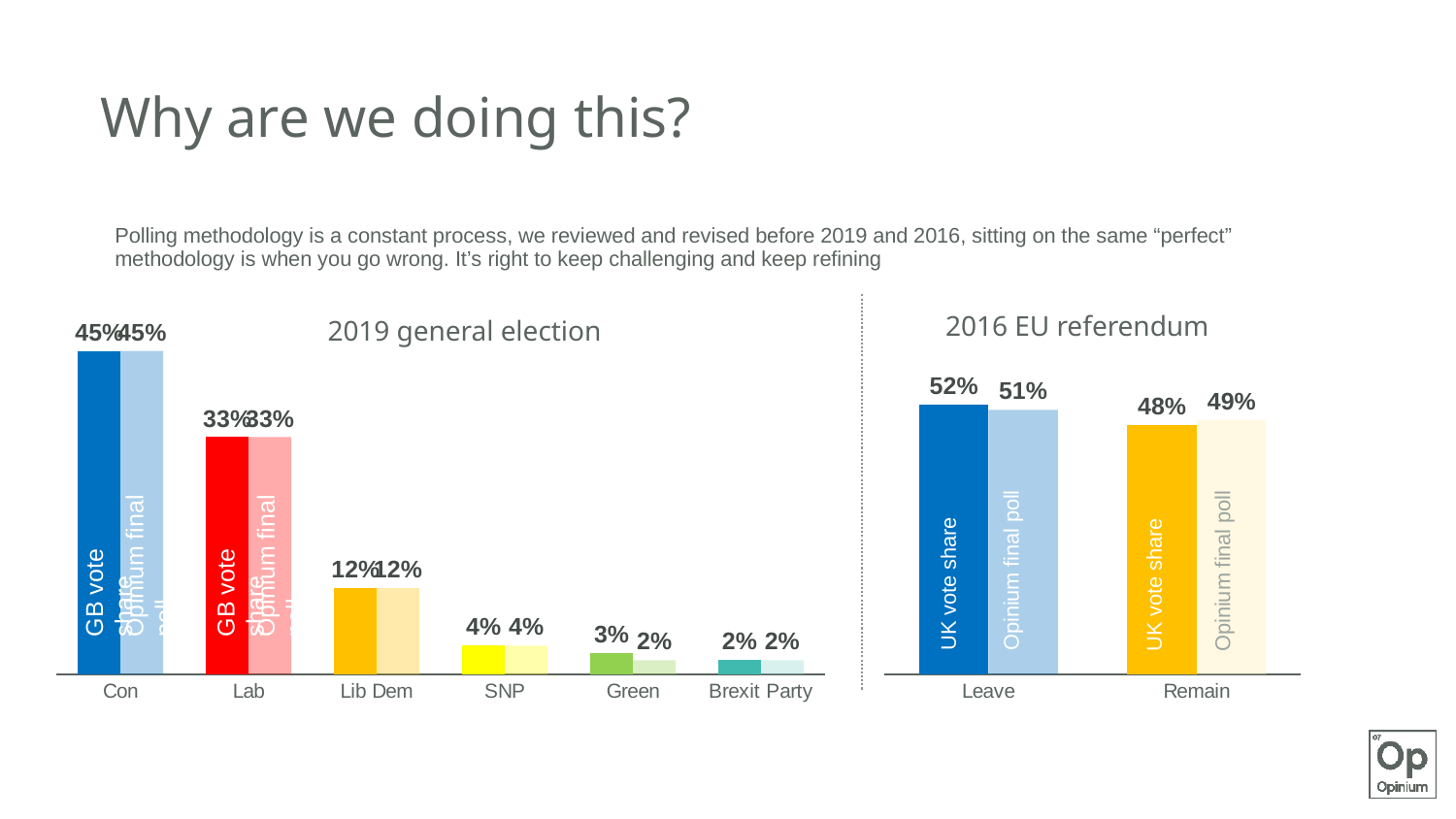
In the 2019 general election chart, which party has the lowest GB vote share? Brexit Party In the 2019 general election chart, what is the GB vote share for Con? 45% In the 2019 general election chart, which party has the highest GB vote share? Con What type of chart is the 2016 EU referendum chart? Bar chart In the 2019 general election chart, what is the difference between the GB vote share for Con and for Lab? 12% In the 2019 general election chart, what is the Opinium final poll value for Green? 2% In the 2016 EU referendum chart, what is the Opinium final poll value for Remain? 49% In the 2016 EU referendum chart, what is the UK vote share for Leave? 52% In the 2016 EU referendum chart, which is larger: the UK vote share for Leave or for Remain? Leave In the 2016 EU referendum chart, what is the difference between the UK vote share for Leave and the Opinium final poll for Leave? 1% How many bars are shown for each category in the 2016 EU referendum chart? 2 How many parties are shown on the x axis of the 2019 general election chart? 6